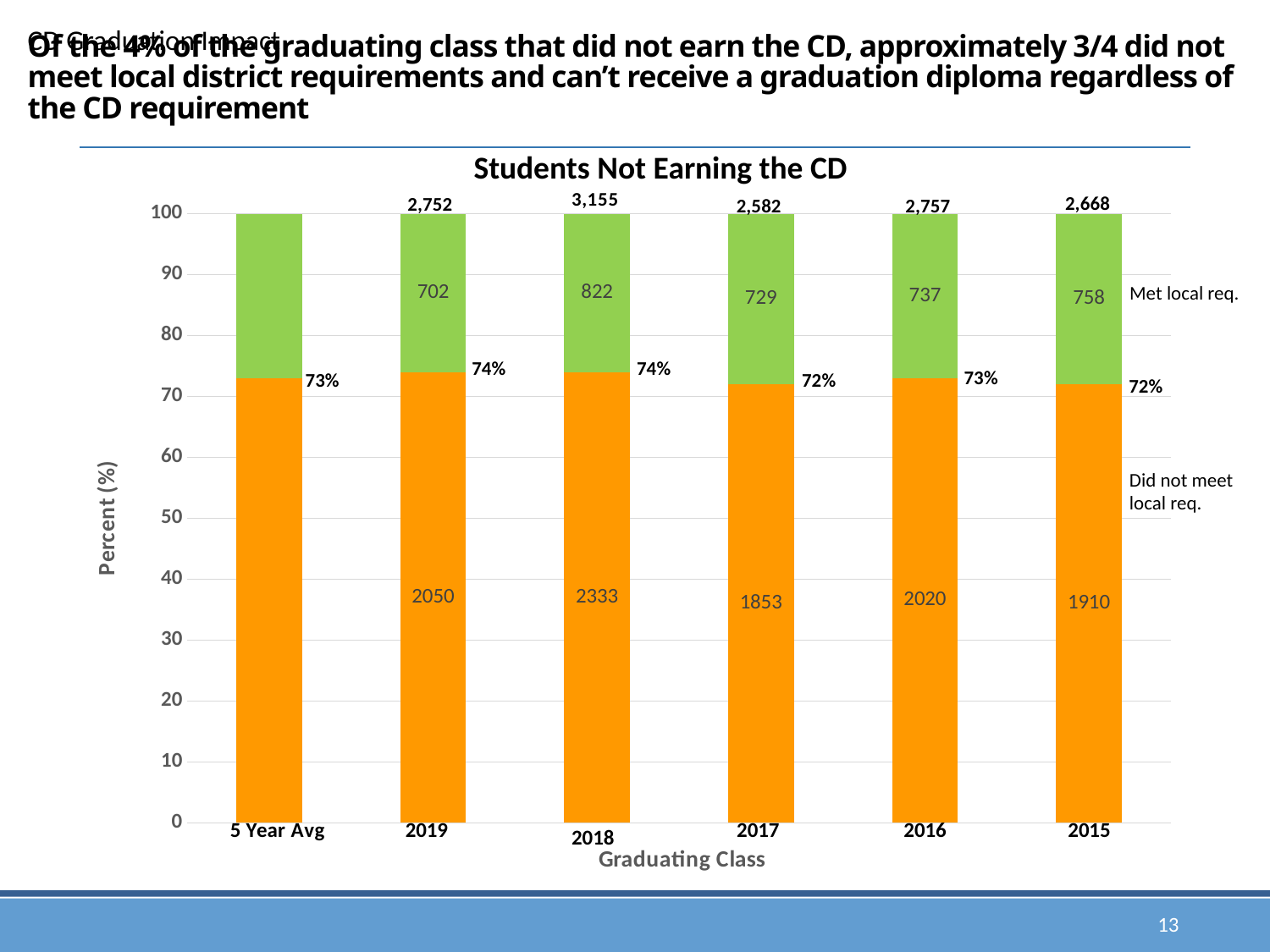
What label does the chart use for the green segment of the bars? Met local req. What is the title of the chart? Students Not Earning the CD What is the difference between the number of students who did not meet local requirements in 2018 and in 2019? 283 Which graduating class has the lowest number of students who did not meet local requirements? 2017 What percentage of students not earning the CD did not meet local requirements for the 5 Year Avg? 73% How many graduating class categories are shown on the x axis of the chart? 6 What is the total number of students not earning the CD shown above the 2017 bar? 2,582 What kind of chart is shown on the slide? Stacked bar chart Which is larger: the number of students who met local requirements in 2016 or in 2017? 2016 Which graduating class has the highest total number of students not earning the CD? 2018 How many students in the 2015 graduating class met local requirements? 758 How many students in the 2018 graduating class did not meet local requirements? 2333